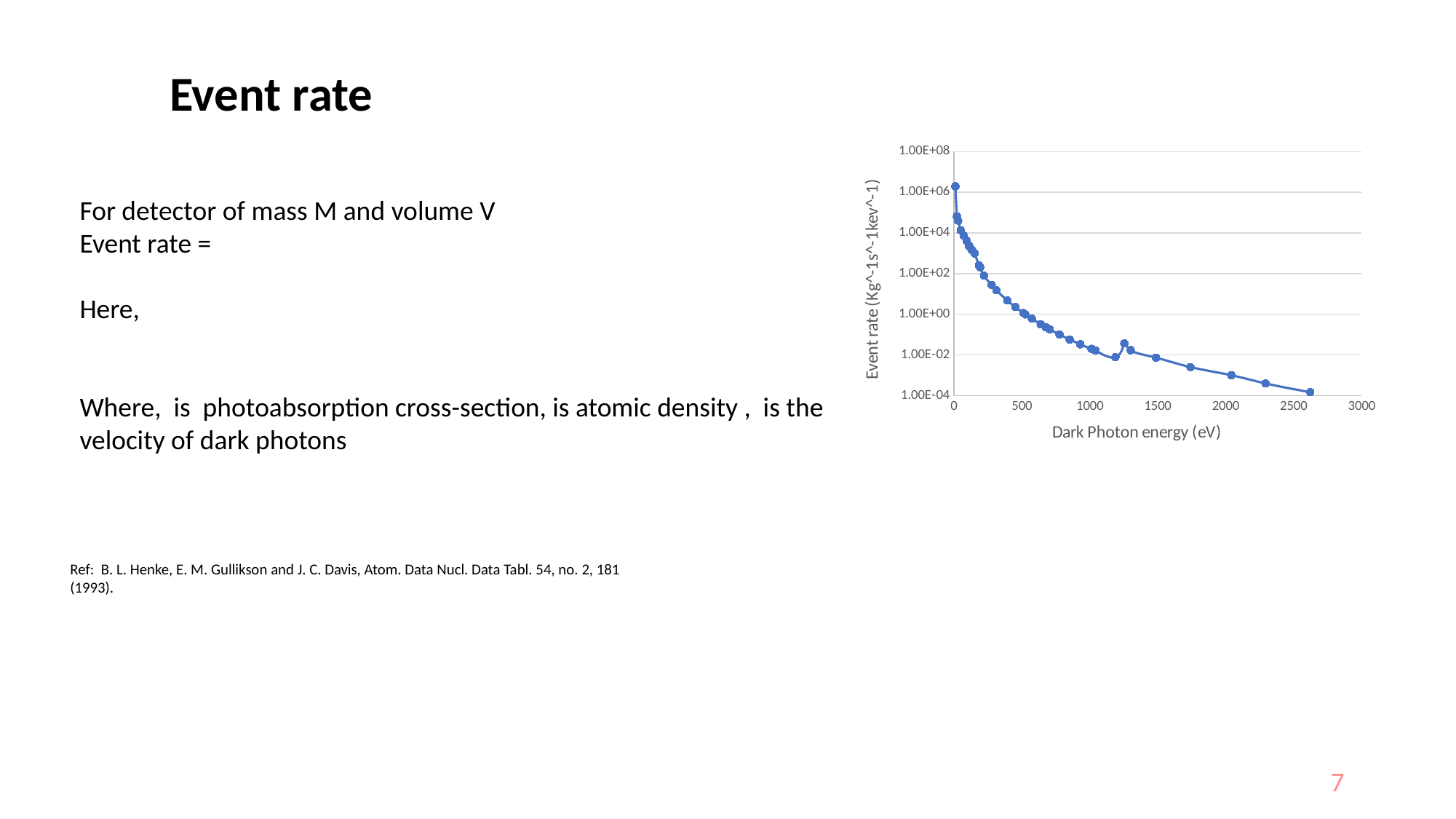
Which has the larger event rate: the point near 500 eV or the point near 2000 eV? the point near 500 eV Is the event rate at around 2000 eV greater or less than 1.00E-02? less What is the label of the y axis of the chart? Event rate (Kg^-1s^-1kev^-1) What kind of chart is shown on the slide? line chart Is the event rate at the highest plotted energy (around 2600 eV) greater or less than 1.00E-02? less What is the highest value shown on the x axis of the chart? 3000 Is the event rate at the lowest plotted energy (near 0 eV) greater or less than 1.00E+04? greater Does the event rate generally rise or fall as dark photon energy increases? fall At which end of the energy range is the event rate highest? the low-energy end (near 0 eV) What is the label of the x axis of the chart? Dark Photon energy (eV)